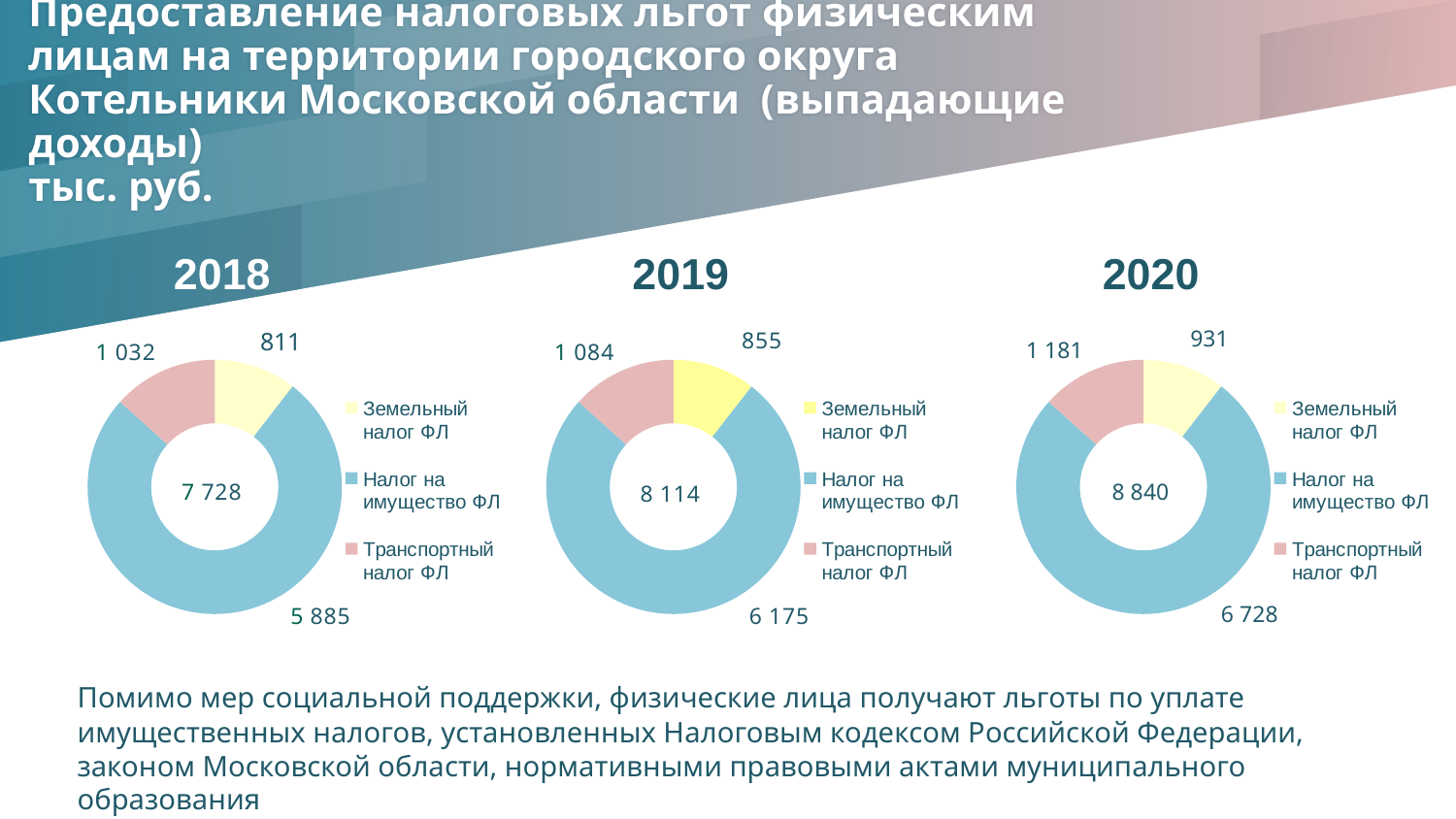
In the 2019 chart, what is the value for Земельный налог ФЛ? 855 In the 2020 chart, which category has the largest value? Налог на имущество ФЛ What total is shown in the centre of the 2019 chart? 8 114 In the 2020 chart, what is the value for Транспортный налог ФЛ? 1 181 How many categories does each chart show? 3 What kind of chart is used for the 2018 data? Doughnut chart In the 2019 chart, what is the difference between Транспортный налог ФЛ and Земельный налог ФЛ? 229 In the 2018 chart, which category has the smallest value? Земельный налог ФЛ Which is larger: Налог на имущество ФЛ in 2018 or Налог на имущество ФЛ in 2020? 2020 How does the value for Земельный налог ФЛ change from 2018 to 2020? It rises In the 2020 chart, which colour represents Налог на имущество ФЛ? Blue In the 2018 chart, what is the value for Налог на имущество ФЛ? 5 885